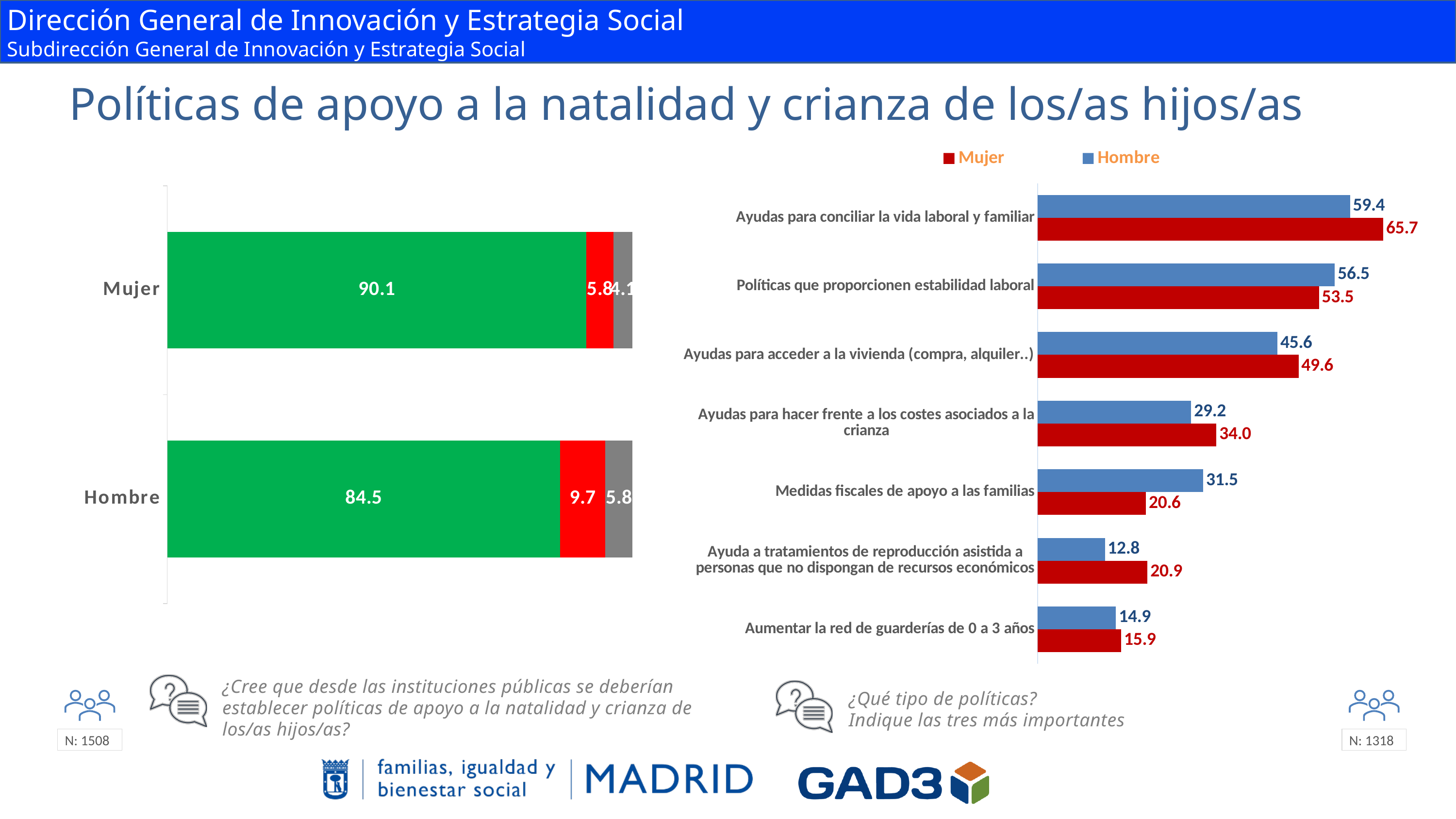
On the left chart, what is the value of the red segment for Hombre? 9.7 On the right chart, which category has the highest Hombre value? Ayudas para conciliar la vida laboral y familiar On the right chart, which category has the lowest Mujer value? Aumentar la red de guarderías de 0 a 3 años On the right chart, what is the Mujer value for 'Ayudas para conciliar la vida laboral y familiar'? 65.7 On the right chart, how many series does the legend list? 2 On the left chart, what is the value of the green segment for Hombre? 84.5 On the right chart, what is the Hombre value for 'Medidas fiscales de apoyo a las familias'? 31.5 On the right chart, for 'Políticas que proporcionen estabilidad laboral', which is larger, the Mujer value or the Hombre value? Hombre On the left chart, what is the value of the green segment for Mujer? 90.1 On the left chart, what is the difference between the green segment values for Mujer and Hombre? 5.6 On the left chart, what kind of chart is shown? Stacked bar chart On the right chart, what is the difference between the Mujer and Hombre values for 'Ayuda a tratamientos de reproducción asistida a personas que no dispongan de recursos económicos'? 8.1